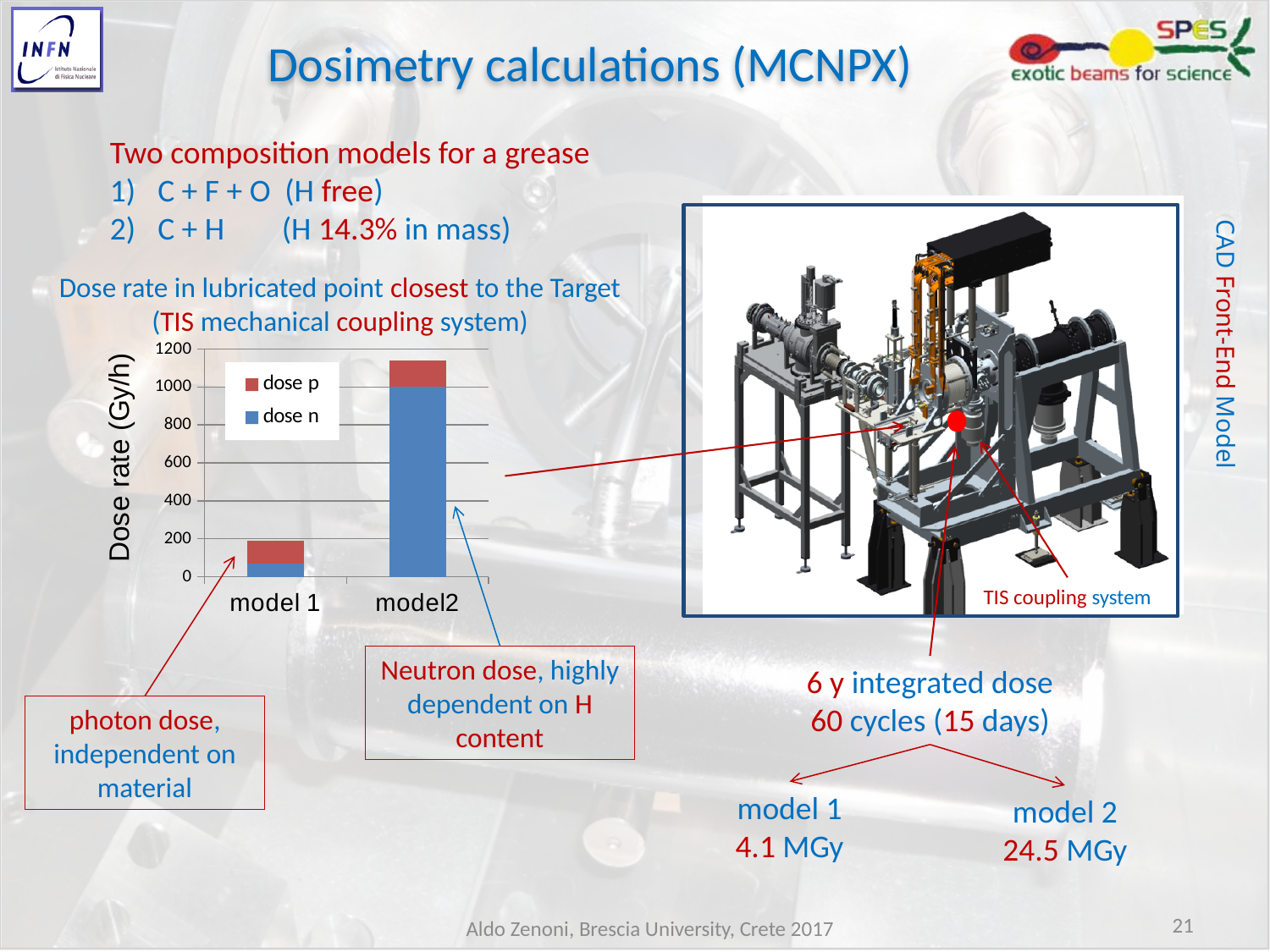
How many categories are plotted on the x axis of the chart? 2 Is the dose n value for model2 greater or less than 800? greater What kind of chart is shown on the slide? stacked bar chart Which category has the lowest total dose rate? model 1 Is the dose n value for model 1 greater or less than 200? less Is the total dose rate for model 1 greater or less than 400? less Does the total dose rate rise or fall from model 1 to model2? rise What are the two series named in the chart's legend? dose p and dose n What is the label of the chart's vertical axis? Dose rate (Gy/h) How many series does the chart's legend list? 2 Which category has the higher total dose rate, model 1 or model2? model2